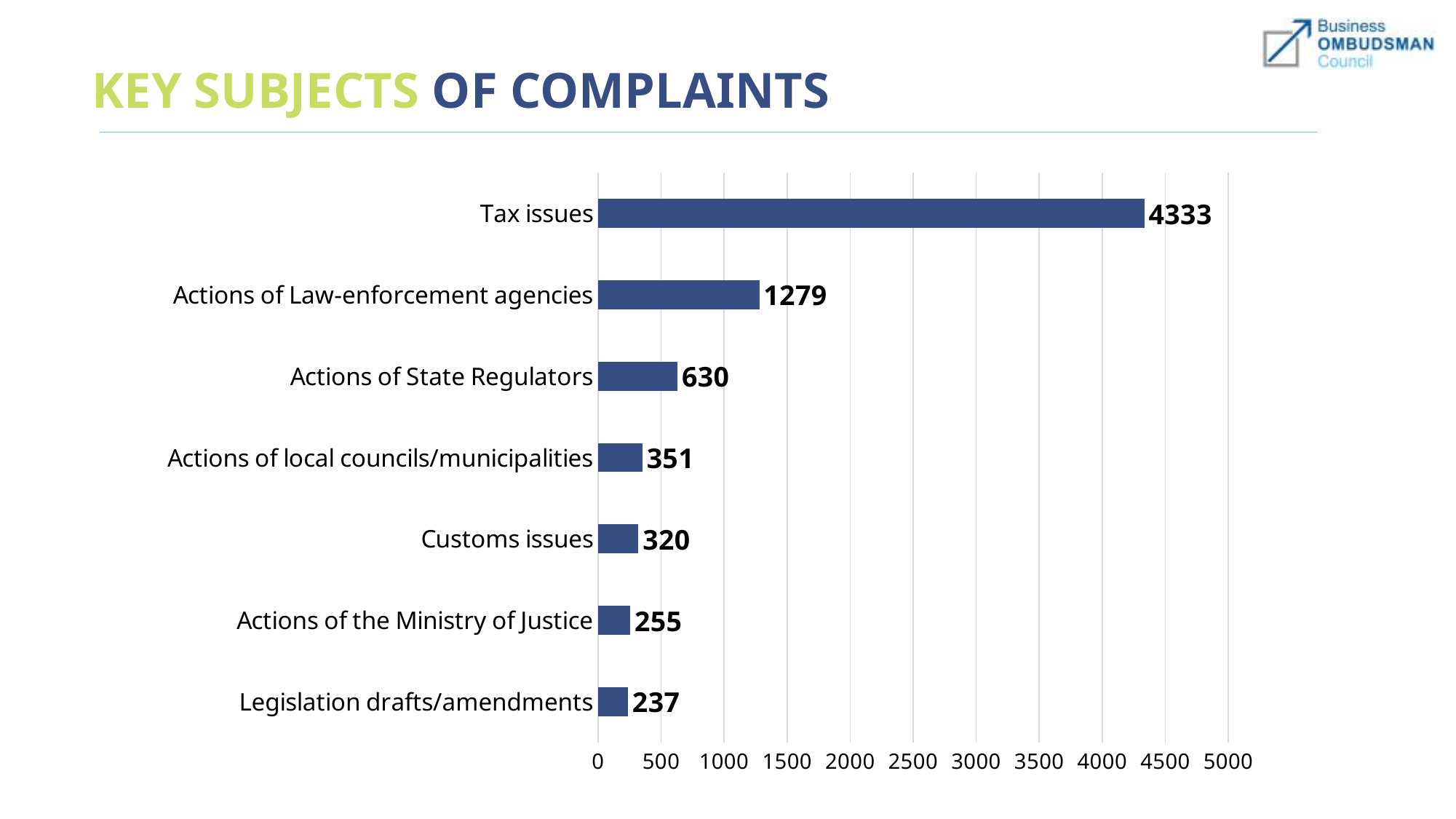
What is the value for Tax issues? 4333 What is the value for Legislation drafts/amendments? 237 What is the title of the slide? KEY SUBJECTS OF COMPLAINTS Which is larger, the value for Customs issues or the value for Actions of the Ministry of Justice? Customs issues What is the value for Customs issues? 320 What is the difference between the values for Tax issues and Actions of Law-enforcement agencies? 3054 Which category has the lowest value? Legislation drafts/amendments Which category has the highest value? Tax issues What is the difference between the values for Actions of State Regulators and Actions of local councils/municipalities? 279 What is the value for Actions of Law-enforcement agencies? 1279 How many categories are shown in the chart? 7 What kind of chart is shown on the slide? Bar chart